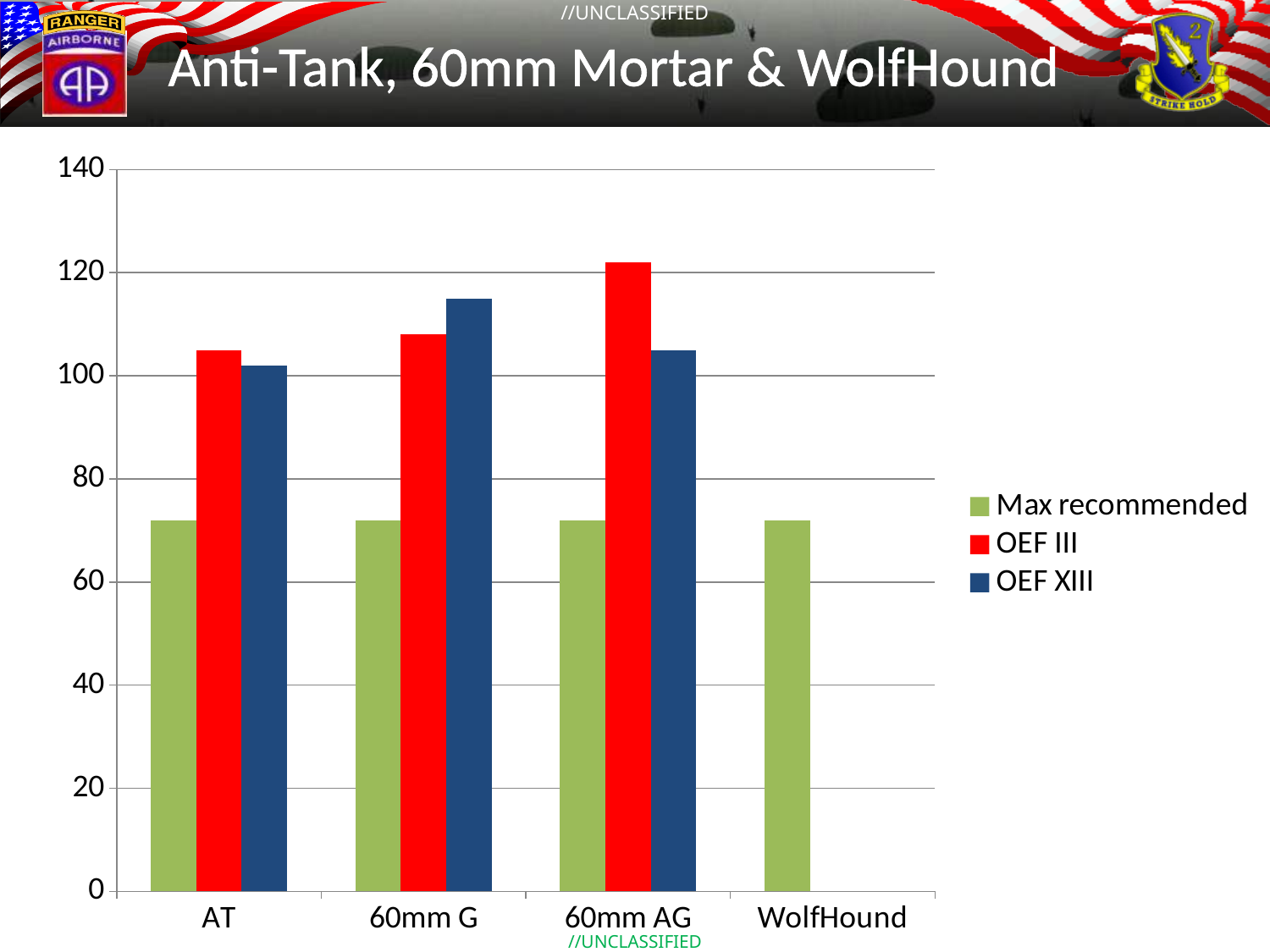
Which category has the highest OEF III value? 60mm AG What kind of chart is shown on the slide? bar chart Is the OEF III value for 60mm AG greater or less than 100? greater Which category has only a Max recommended bar and no OEF III or OEF XIII bars? WolfHound What is the title of the slide containing the chart? Anti-Tank, 60mm Mortar & WolfHound Is the Max recommended value for WolfHound greater or less than 80? less For 60mm G, which is larger: the OEF III value or the OEF XIII value? OEF XIII Is the OEF XIII value for 60mm G greater or less than 100? greater Which category has the highest OEF XIII value? 60mm G How many series does the chart's legend list? 3 For 60mm AG, which is larger: the OEF III value or the OEF XIII value? OEF III How many categories are shown on the x axis of the chart? 4